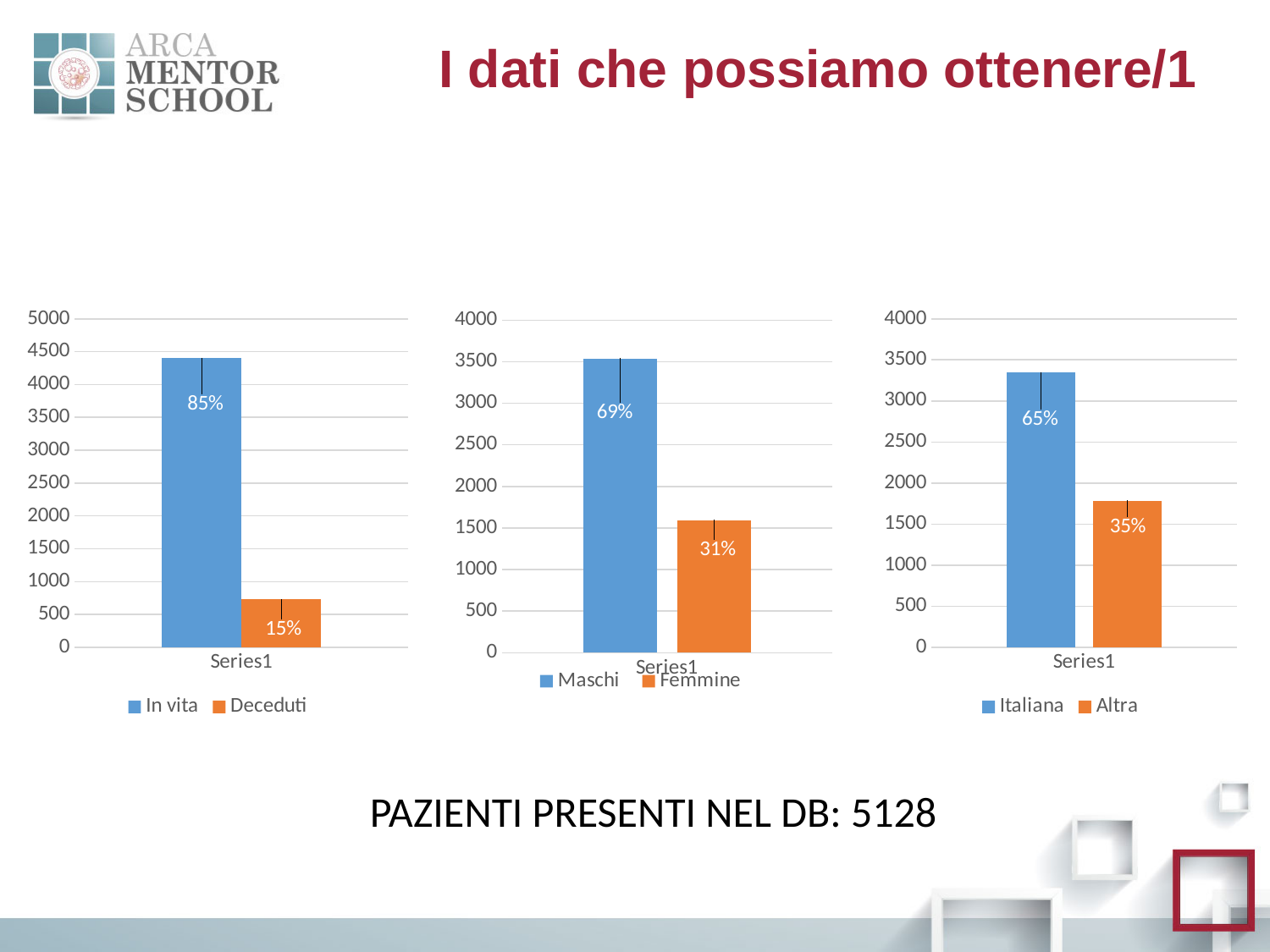
In the right chart, which series has the taller bar, Italiana or Altra? Italiana In the right chart, is the value for Italiana greater or less than 3000? greater In the middle chart, what data label is shown on the Maschi bar? 69% What kind of chart is the left chart? bar chart In the left chart, what data label is shown on the Deceduti bar? 15% In the right chart, what data label is shown on the Altra bar? 35% In the left chart, is the value for In vita greater or less than 4000? greater How many series does the legend of the middle chart list? 2 In the right chart, what data label is shown on the Italiana bar? 65% In the middle chart, is the value for Femmine greater or less than 2000? less In the middle chart, what data label is shown on the Femmine bar? 31% In the left chart, what data label is shown on the In vita bar? 85%